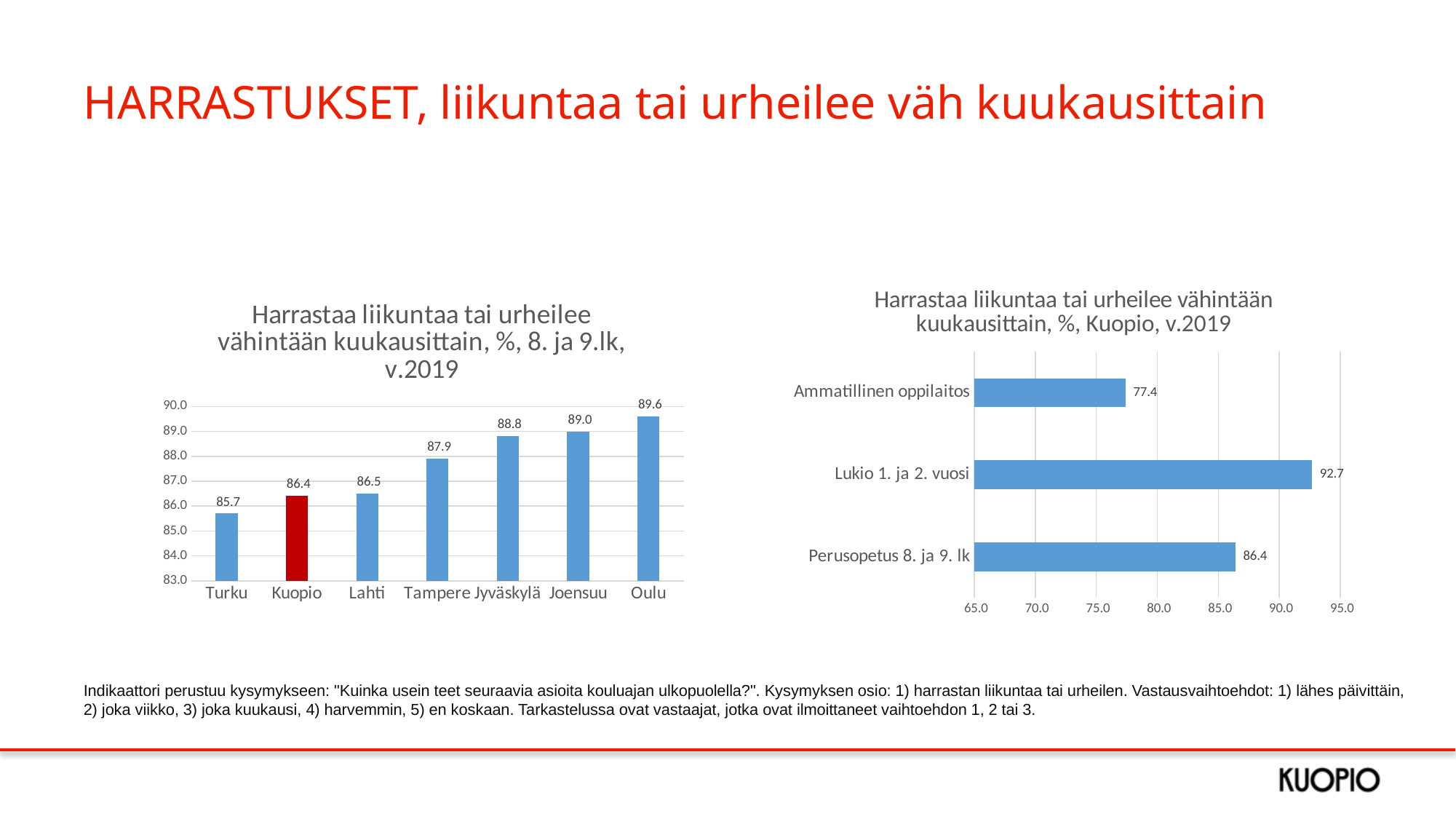
In the left chart (8. ja 9.lk, v.2019), which is larger, Jyväskylä or Joensuu? Joensuu In the right chart (Kuopio, v.2019), which category has the lowest value? Ammatillinen oppilaitos In the left chart (8. ja 9.lk, v.2019), do the values rise or fall from Turku to Oulu? rise In the right chart (Kuopio, v.2019), what is the value for Lukio 1. ja 2. vuosi? 92.7 In the left chart (8. ja 9.lk, v.2019), how many cities are shown? 7 In the left chart (8. ja 9.lk, v.2019), which city has the highest value? Oulu In the left chart (8. ja 9.lk, v.2019), which bar is coloured red? Kuopio In the left chart (8. ja 9.lk, v.2019), what is the value for Kuopio? 86.4 In the left chart (8. ja 9.lk, v.2019), what is the difference between Oulu and Turku? 3.9 In the left chart (8. ja 9.lk, v.2019), which city has the lowest value? Turku In the right chart (Kuopio, v.2019), what is the difference between Lukio 1. ja 2. vuosi and Ammatillinen oppilaitos? 15.3 In the left chart (8. ja 9.lk, v.2019), what is the value for Tampere? 87.9